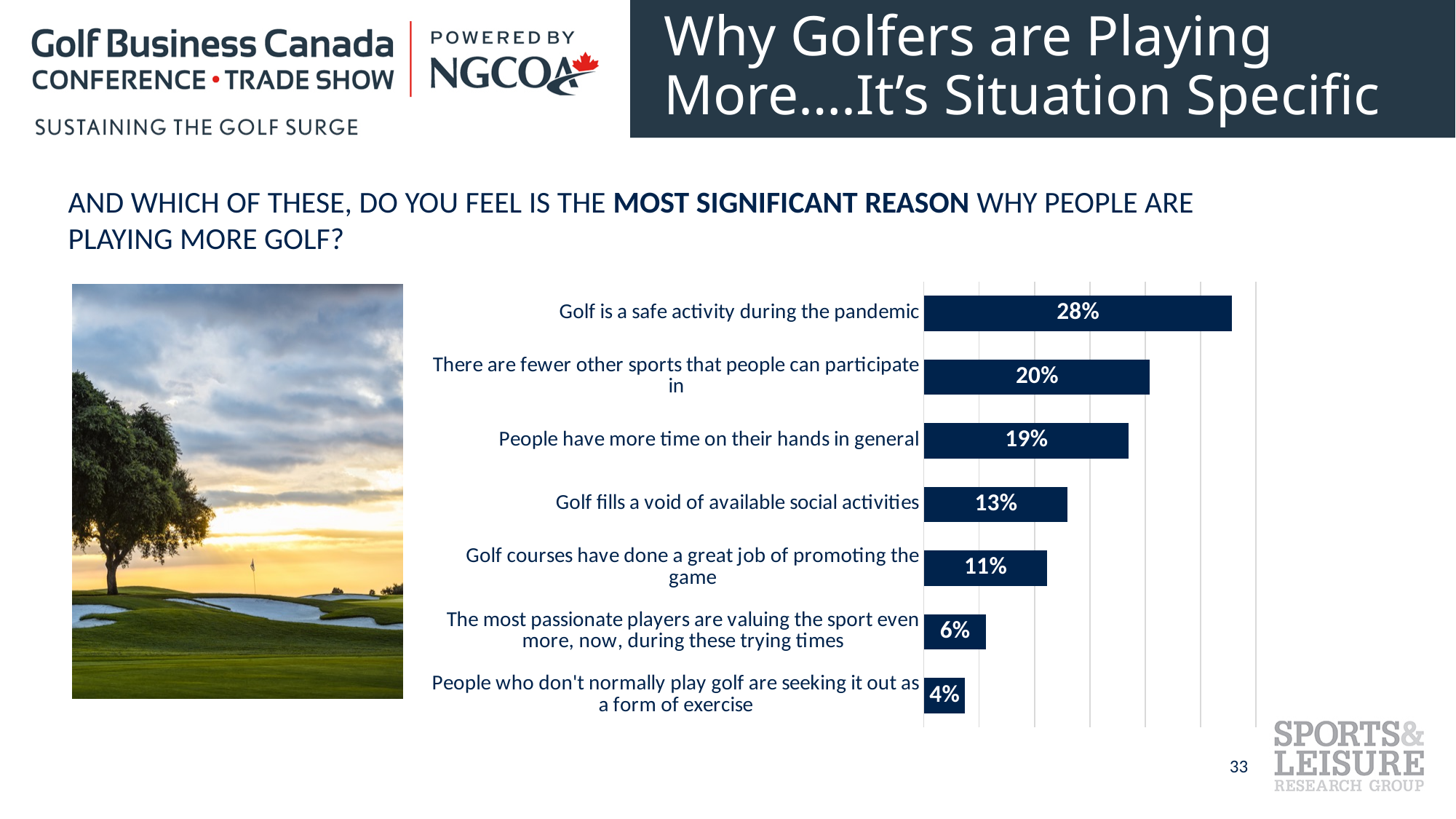
What is the difference in percentage points between "Golf is a safe activity during the pandemic" and "There are fewer other sports that people can participate in"? 8 What percentage is shown for "Golf courses have done a great job of promoting the game"? 11% What type of chart is used on this slide? Bar chart Which reason has the highest percentage in the chart? Golf is a safe activity during the pandemic How many reasons (categories) are shown in the bar chart? 7 What is the difference in percentage points between "Golf fills a void of available social activities" and "The most passionate players are valuing the sport even more, now, during these trying times"? 7 Which reason has the lowest percentage in the chart? People who don't normally play golf are seeking it out as a form of exercise What is the value for "People have more time on their hands in general"? 19% Which is larger: the value for "Golf fills a void of available social activities" or the value for "Golf courses have done a great job of promoting the game"? Golf fills a void of available social activities What percentage of respondents chose "Golf is a safe activity during the pandemic" as the most significant reason? 28% What colour are the bars in the chart? Dark navy blue Do the bar values increase or decrease from the top of the chart to the bottom? Decrease